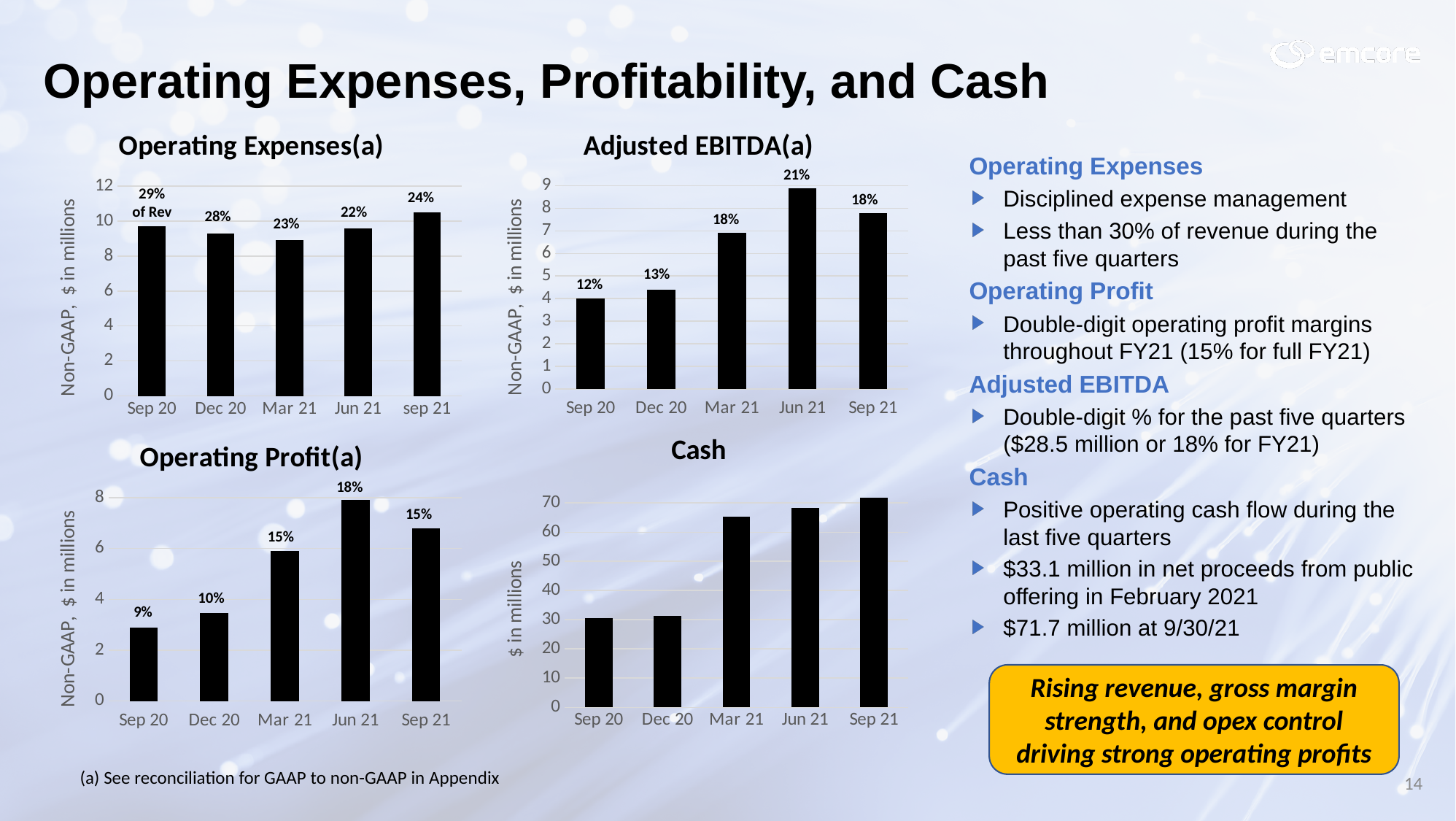
In the Operating Profit(a) chart, is the value for Dec 20 greater or less than 4? less How many quarters are shown on the x axis of the Cash chart? 5 In the Cash chart, is the value for Mar 21 greater or less than 60? greater In the Operating Profit(a) chart, what percentage label is shown for Sep 20? 9% In the Adjusted EBITDA(a) chart, which quarter has the lowest bar? Sep 20 In the Operating Expenses(a) chart, which quarter has the tallest bar? sep 21 In the Adjusted EBITDA(a) chart, what percentage label is shown for Jun 21? 21% In the Cash chart, which quarter has the highest bar? Sep 21 In the Adjusted EBITDA(a) chart, is the value for Mar 21 greater or less than 6? greater In the Operating Profit(a) chart, which quarter has the highest bar? Jun 21 In the Operating Expenses(a) chart, what percentage of revenue label is shown for Mar 21? 23%